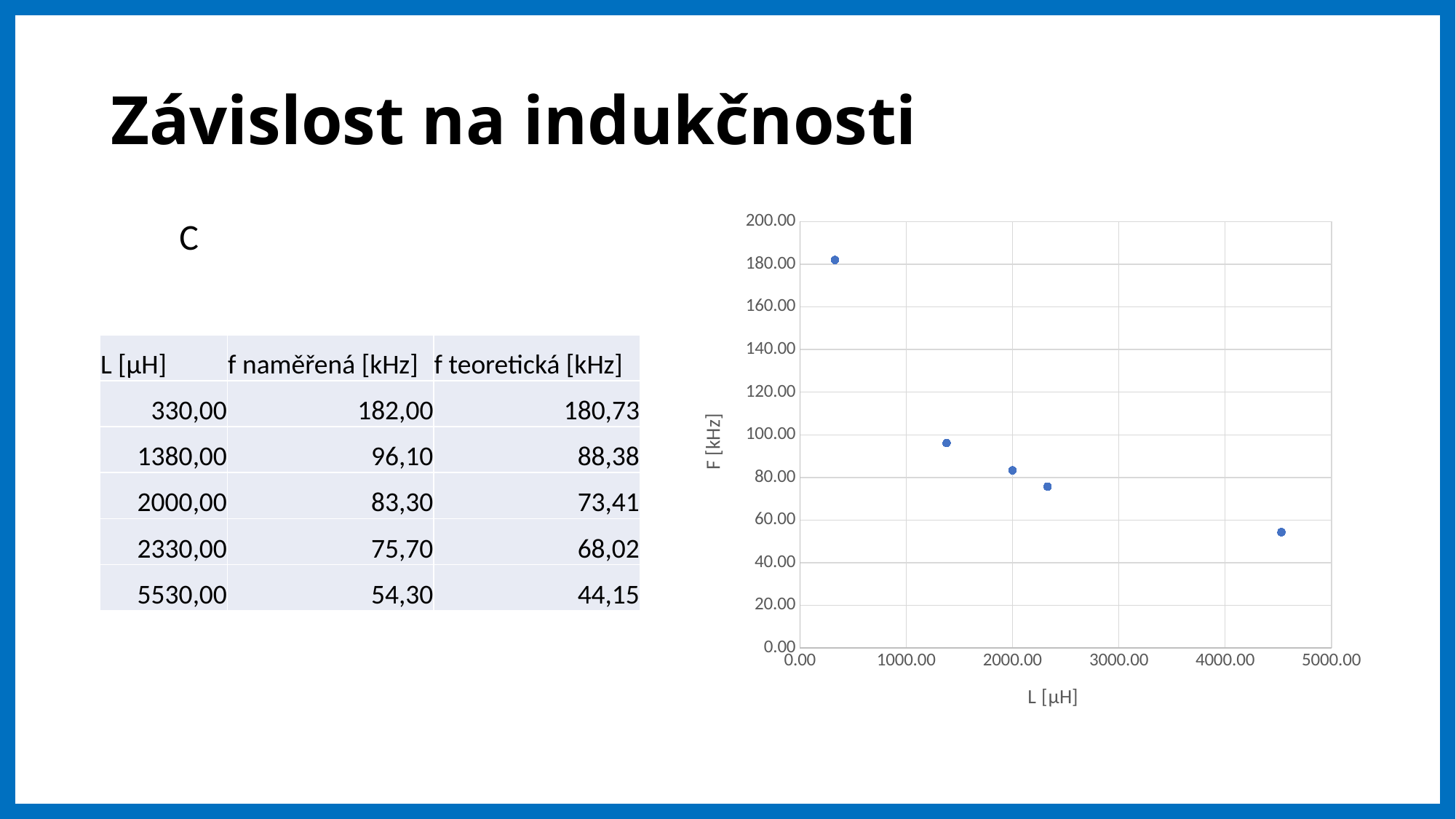
Do the F values rise or fall as L increases along the x axis? fall Which point has the highest F value, the leftmost or the rightmost? leftmost Is the L value of the rightmost point greater or less than 4000? greater Is the F value of the leftmost point (near L = 330) greater or less than 160? greater Is the F value of the rightmost point greater or less than 80? less How many data points are plotted in the chart? 5 What is the title of the chart's vertical axis? F [kHz] What kind of chart is shown on the slide? scatter chart What is the title of the chart's horizontal axis? L [µH] Which point has a larger F value: the one near L = 2000 or the one near L = 4500? the one near L = 2000